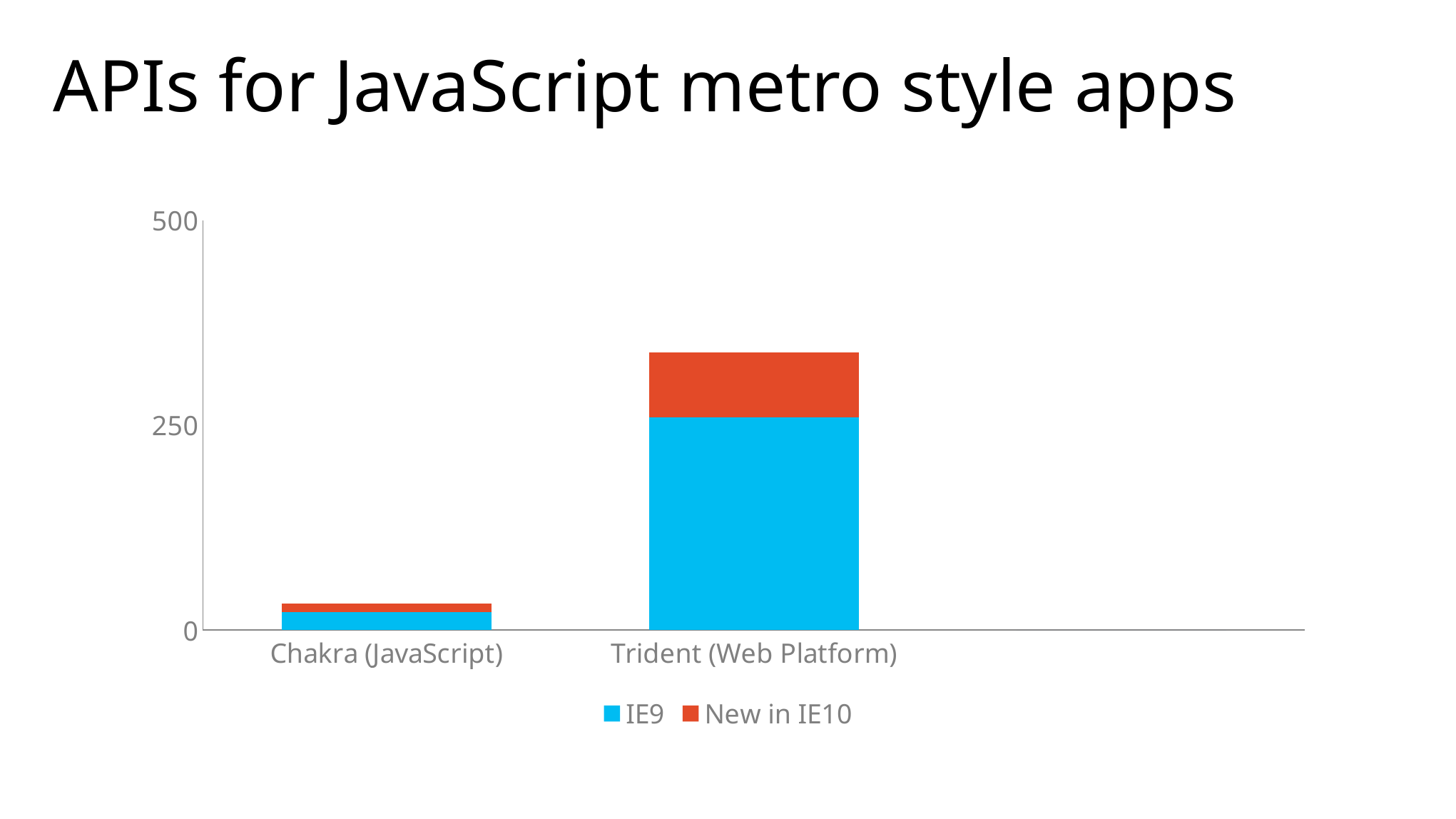
Which category has the tallest stacked bar? Trident (Web Platform) What kind of chart is shown on the slide? Stacked bar chart What is the title of the chart on the slide? APIs for JavaScript metro style apps Which has a larger total, Chakra (JavaScript) or Trident (Web Platform)? Trident (Web Platform) Is the total stacked value for Trident (Web Platform) greater or less than 250? greater Is the total stacked value for Chakra (JavaScript) greater or less than 250? less Which series is shown in blue in the chart? IE9 How many categories are shown on the x axis of the chart? 2 Is the total stacked value for Trident (Web Platform) greater or less than 500? less Which category has the larger IE9 value, Chakra (JavaScript) or Trident (Web Platform)? Trident (Web Platform) How many series does the legend list? 2 Which category has the shortest stacked bar? Chakra (JavaScript)